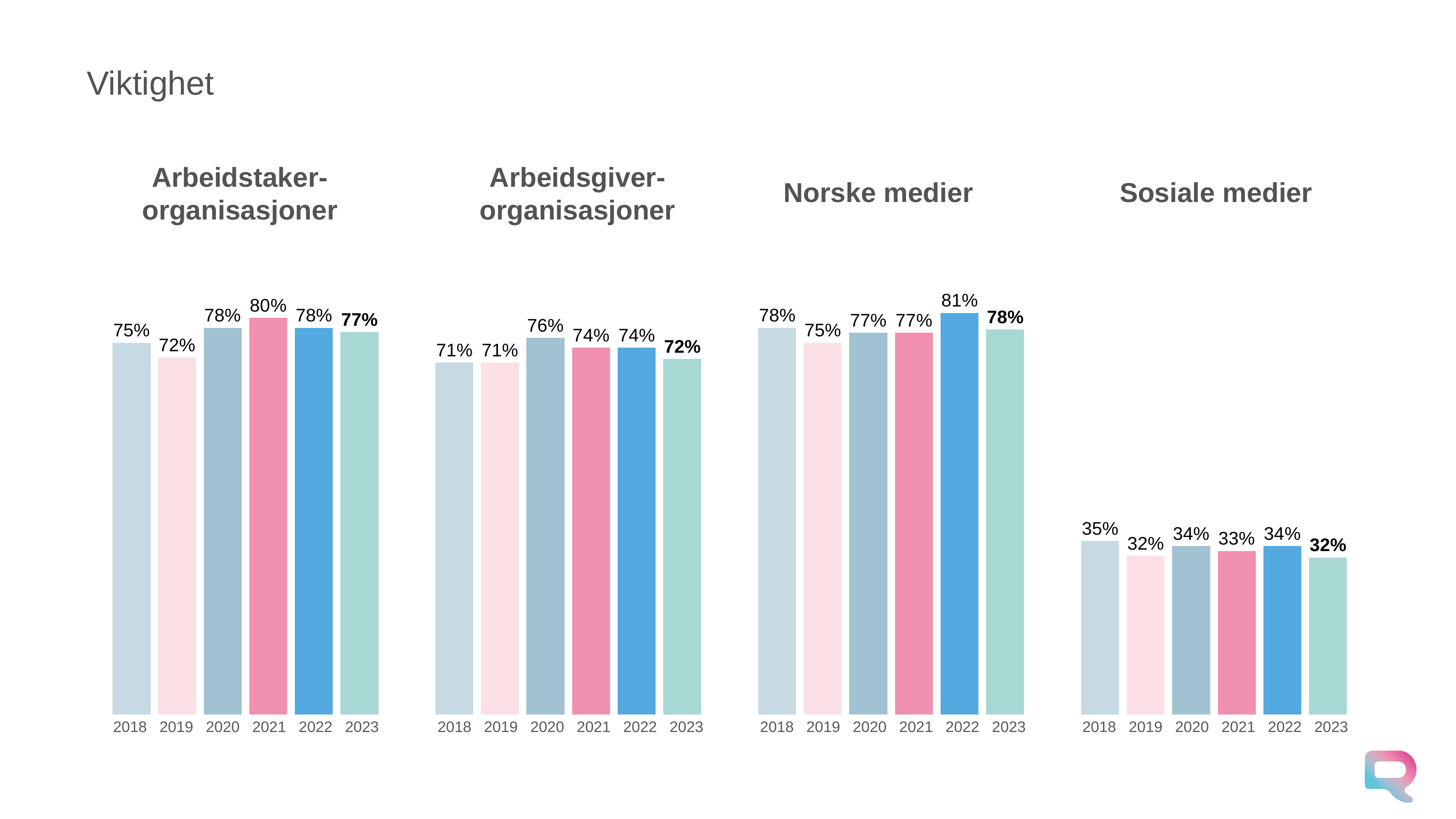
In the Norske medier chart, which year has the highest value? 2022 How many charts are shown on the slide? 4 In the Arbeidstaker-organisasjoner chart, which year has the lowest value? 2019 In the Arbeidstaker-organisasjoner chart, what is the value for 2021? 80% In the Arbeidsgiver-organisasjoner chart, what is the value for 2023? 72% In the Arbeidsgiver-organisasjoner chart, which is larger, the value for 2020 or the value for 2021? 2020 How many years are shown in the Norske medier chart? 6 In the Norske medier chart, what is the difference between the 2022 value and the 2019 value? 6% In the Sosiale medier chart, which year has the highest value? 2018 In the Sosiale medier chart, what is the difference between the 2018 value and the 2023 value? 3% What kind of chart is the Sosiale medier chart? Bar chart In the Sosiale medier chart, what is the value for 2021? 33%